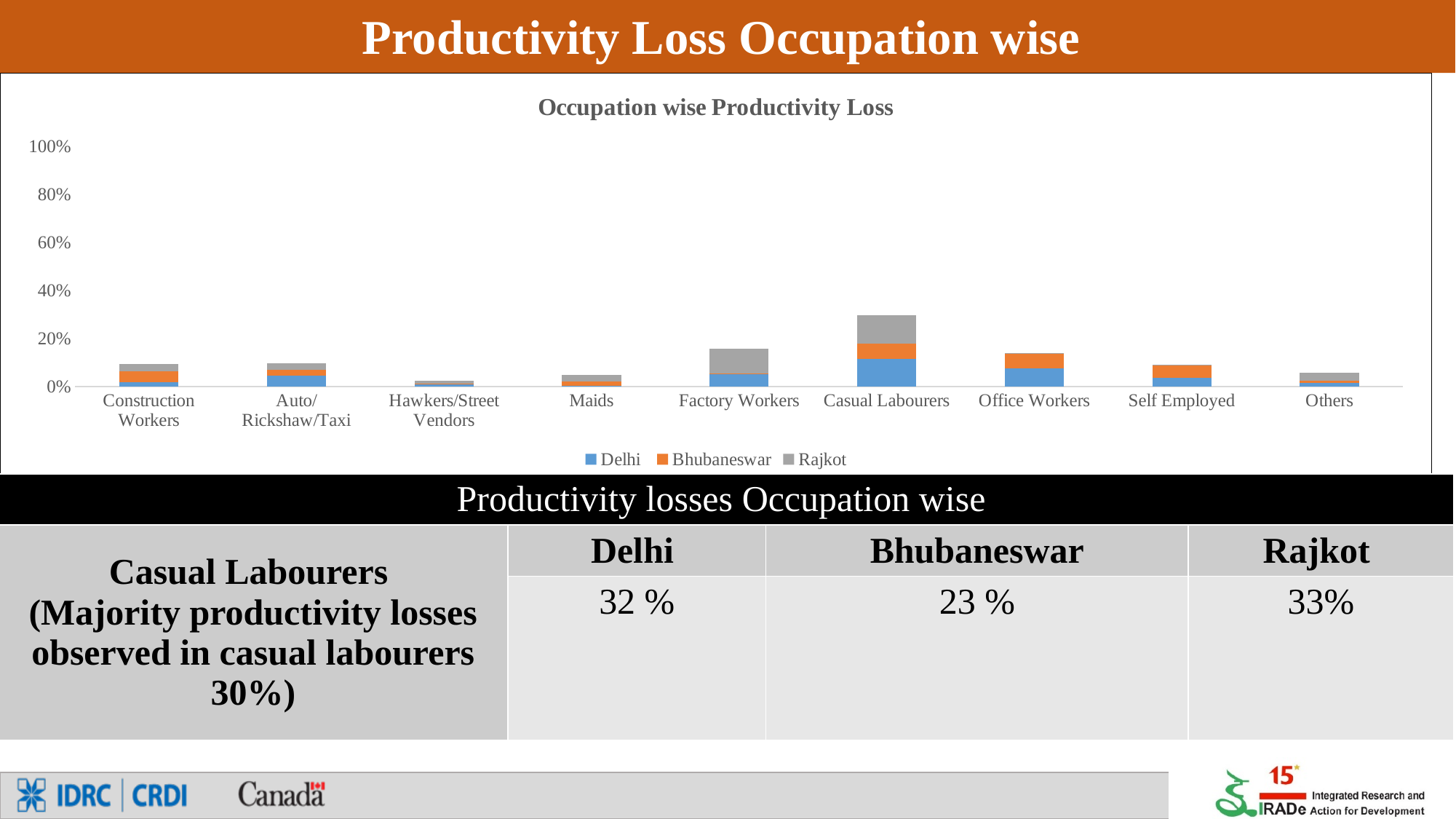
How many series does the chart legend list? 3 Is the total stacked value for Maids greater or less than 20%? less Which occupation has the highest total stacked bar in the chart? Casual Labourers How many occupation categories are shown on the x axis of the chart? 9 Is the total stacked value for Casual Labourers greater or less than 20%? greater Is the total stacked value for Factory Workers greater or less than 20%? less Which has the larger total stacked bar, Casual Labourers or Factory Workers? Casual Labourers Which has the larger total stacked bar, Office Workers or Hawkers/Street Vendors? Office Workers What kind of chart is shown on the slide? Stacked bar chart Which occupation has the lowest total stacked bar in the chart? Hawkers/Street Vendors Which series are listed in the chart legend? Delhi, Bhubaneswar, Rajkot What is the title of the chart? Occupation wise Productivity Loss